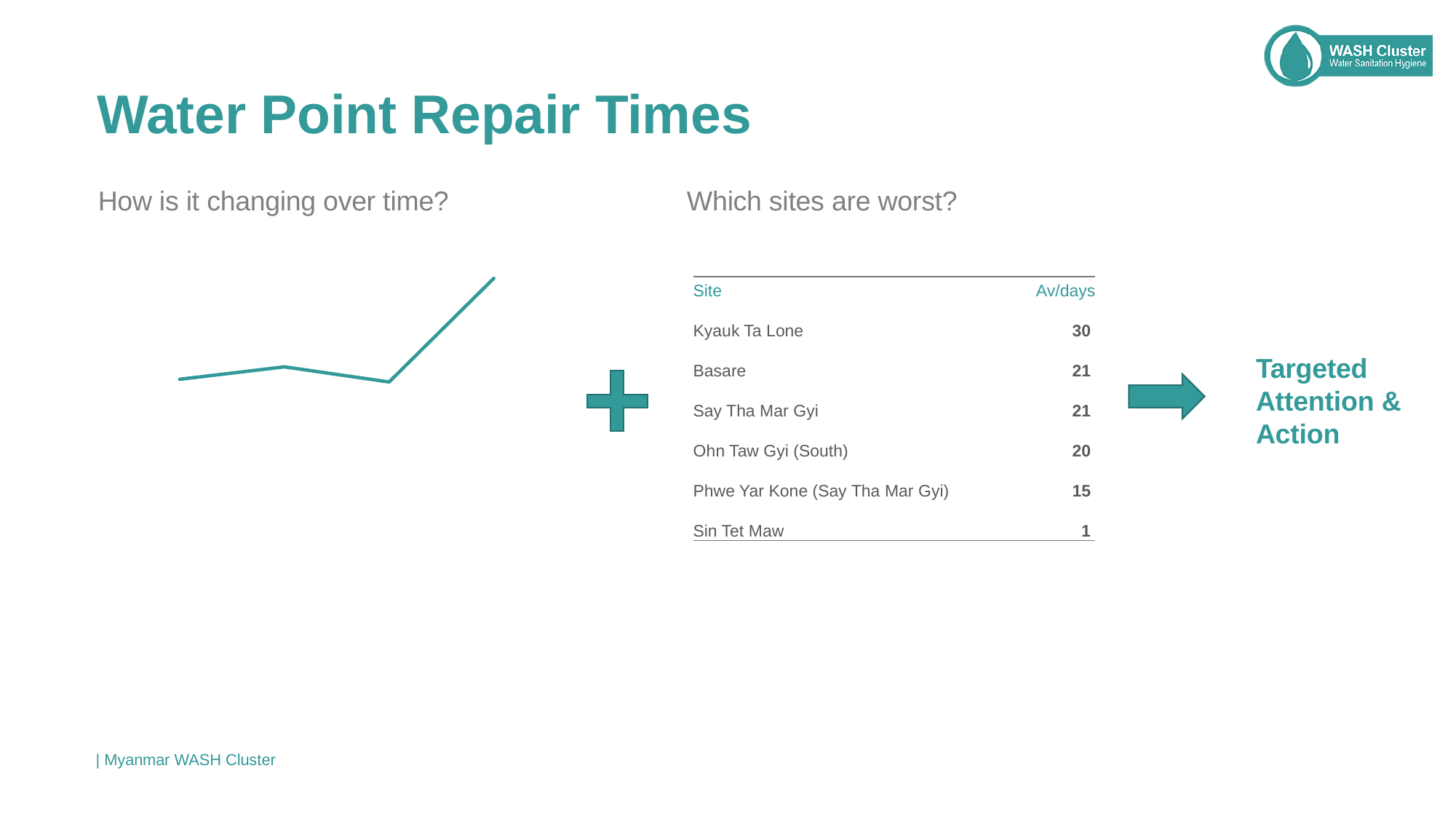
How many sites are listed in the table under "Which sites are worst?"? 6 In the table under "Which sites are worst?", what is the Av/days value for Ohn Taw Gyi (South)? 20 What kind of chart is shown under "How is it changing over time?"? line chart In the table under "Which sites are worst?", what is the Av/days value for Kyauk Ta Lone? 30 In the table under "Which sites are worst?", which has a higher Av/days, Basare or Ohn Taw Gyi (South)? Basare What is the title of the slide? Water Point Repair Times How many lines are plotted in the chart under "How is it changing over time?"? 1 In the table under "Which sites are worst?", which site has the highest Av/days? Kyauk Ta Lone In the table under "Which sites are worst?", what is the difference in Av/days between Kyauk Ta Lone and Phwe Yar Kone (Say Tha Mar Gyi)? 15 In the table under "Which sites are worst?", which site has the lowest Av/days? Sin Tet Maw How many data points does the line in the chart under "How is it changing over time?" connect? 4 In the line chart under "How is it changing over time?", does the line end higher or lower than it starts? higher